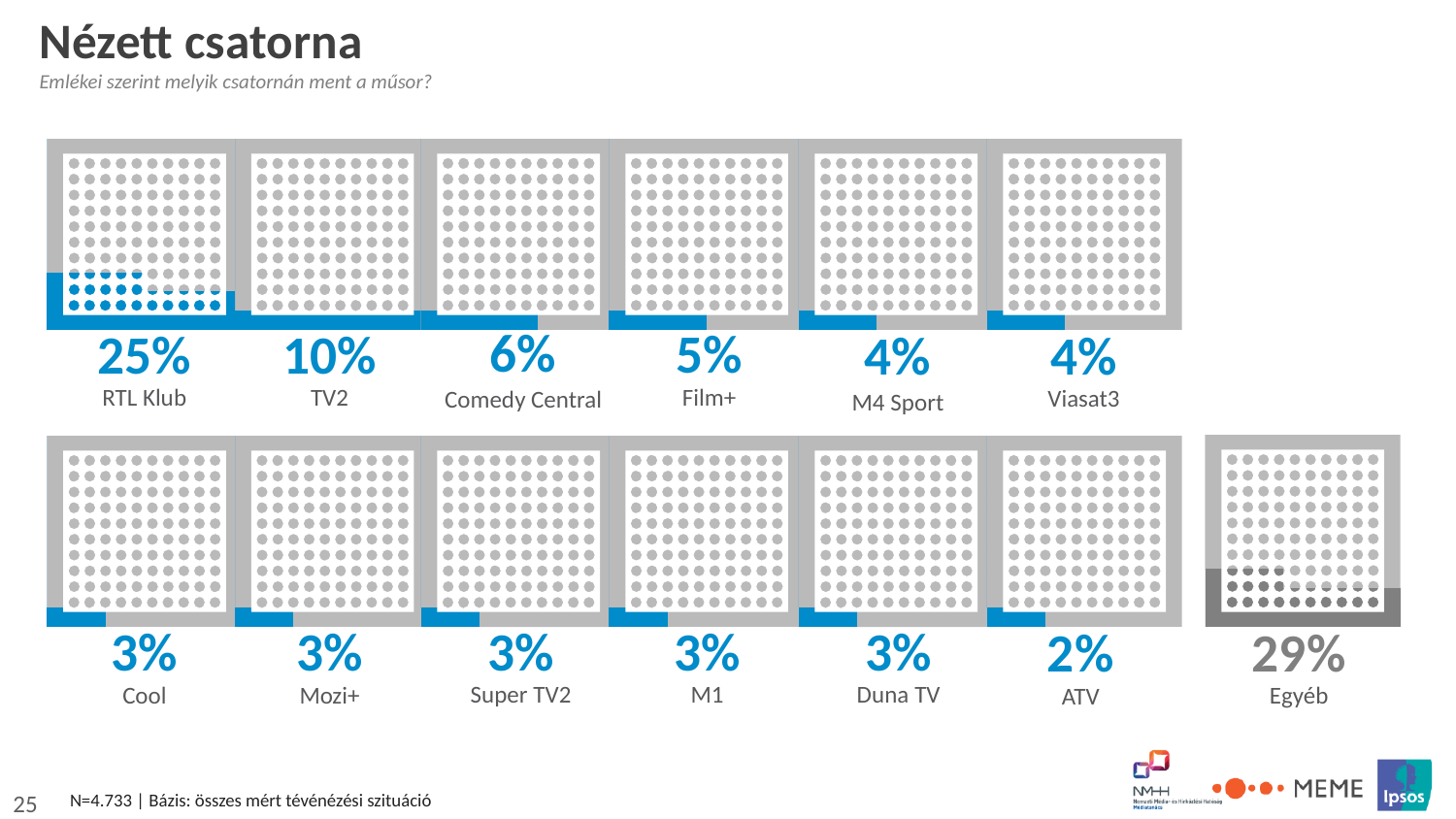
What percentage is shown for ATV? 2% What percentage of respondents said the programme was on RTL Klub? 25% How many channel categories (including Egyéb) are shown on the slide? 13 What is the value shown for TV2? 10% Which has a larger value, Film+ or M4 Sport? Film+ Which channel has the lowest percentage on the slide? ATV What is the title of the chart? Nézett csatorna What kind of chart is used to display the percentages? Waffle chart (grid of dots) What percentage is shown for Comedy Central? 6% Which named channel (excluding Egyéb) has the highest percentage? RTL Klub What is the difference in percentage points between RTL Klub and TV2? 15 percentage points What is the value for the Egyéb (other) category? 29%